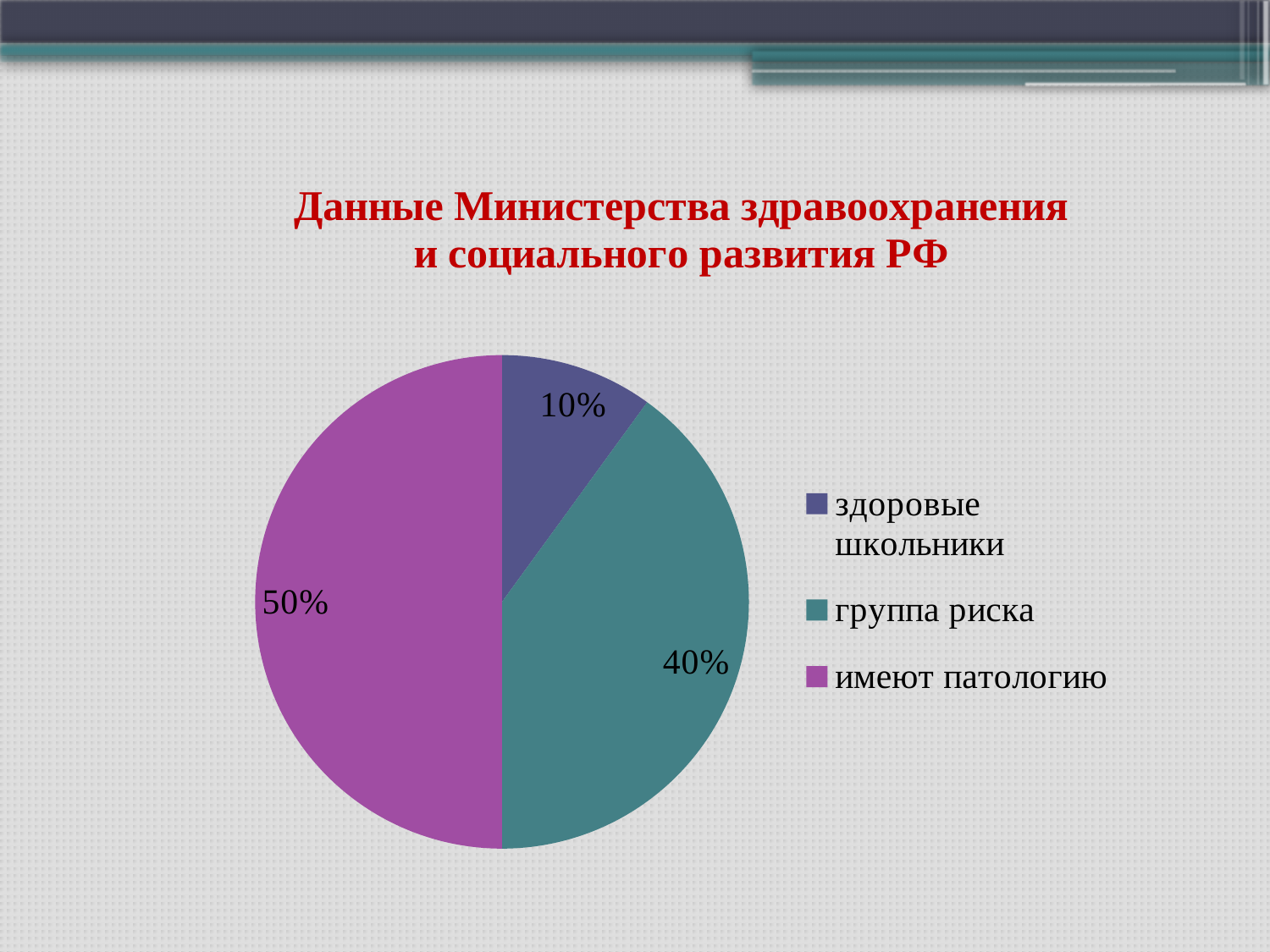
What share of the pie is labelled 'группа риска'? 40% Which category has the largest slice of the pie? имеют патологию What colour is the slice for 'имеют патологию'? purple How many entries does the legend list? 3 What share of the pie is labelled 'здоровые школьники'? 10% How many slices does the pie chart have? 3 What share of the pie is labelled 'имеют патологию'? 50% Which is larger: the slice for 'группа риска' or the slice for 'здоровые школьники'? группа риска What is the difference in percentage points between 'имеют патологию' and 'здоровые школьники'? 40 What type of chart is shown on the slide? pie chart What is the difference in percentage points between 'группа риска' and 'здоровые школьники'? 30 Which category has the smallest slice of the pie? здоровые школьники